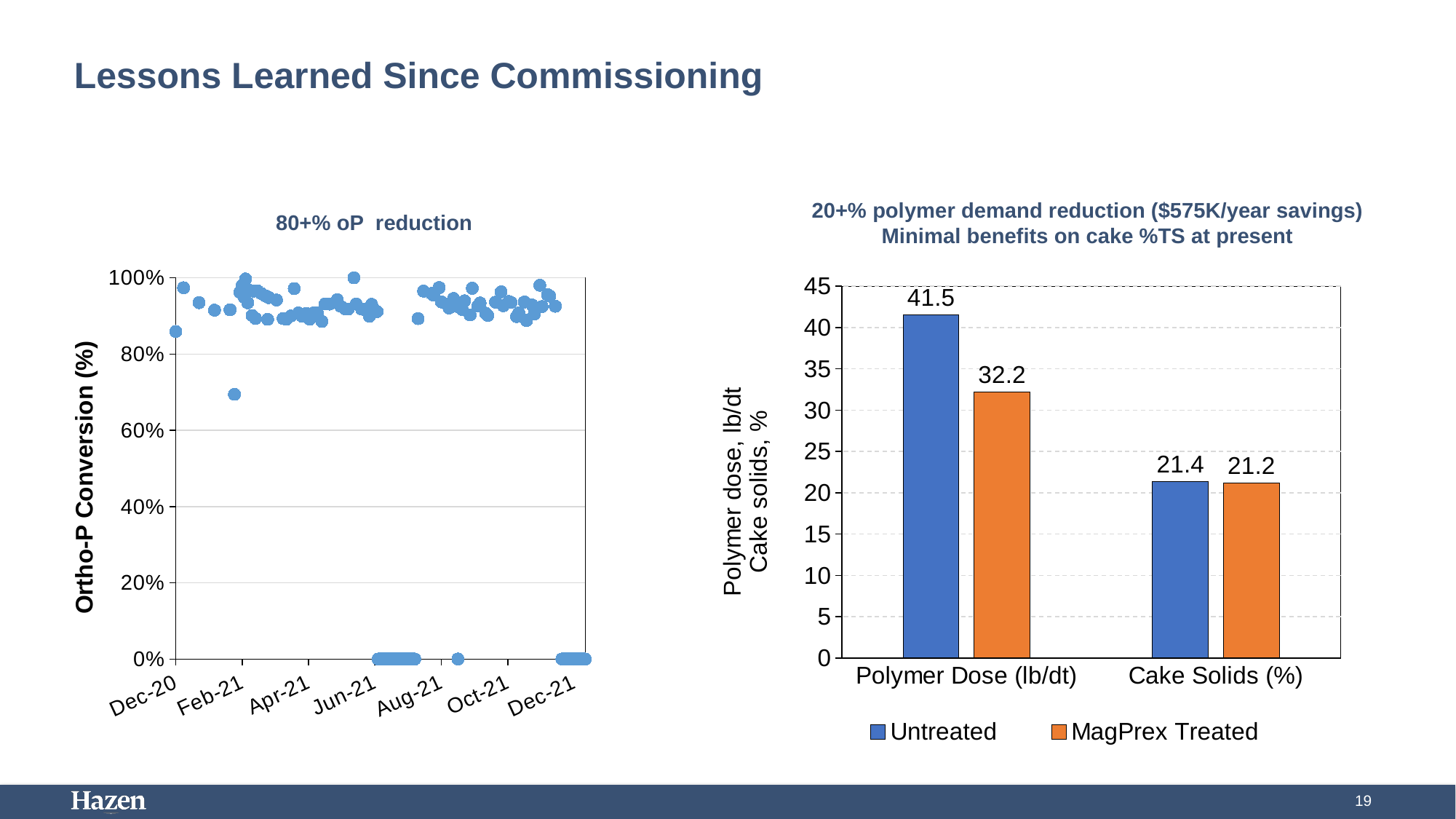
In the right-hand bar chart, what is the Untreated value for Polymer Dose (lb/dt)? 41.5 How many categories are shown on the x axis of the right-hand bar chart? 2 In the right-hand bar chart, what is the difference between the Untreated and MagPrex Treated values for Cake Solids (%)? 0.2 In the right-hand bar chart, what is the Untreated value for Cake Solids (%)? 21.4 What is the y-axis label of the left-hand chart titled '80+% oP reduction'? Ortho-P Conversion (%) In the right-hand bar chart, what is the difference between the Untreated and MagPrex Treated values for Polymer Dose (lb/dt)? 9.3 In the right-hand bar chart, what is the MagPrex Treated value for Cake Solids (%)? 21.2 In the right-hand bar chart, which bar is the tallest? Untreated Polymer Dose (lb/dt) How many series does the legend of the right-hand bar chart list? 2 What kind of chart is the left-hand chart titled '80+% oP reduction'? Scatter chart In the right-hand bar chart, which series has the higher value for Polymer Dose (lb/dt), Untreated or MagPrex Treated? Untreated In the right-hand bar chart, what is the MagPrex Treated value for Polymer Dose (lb/dt)? 32.2